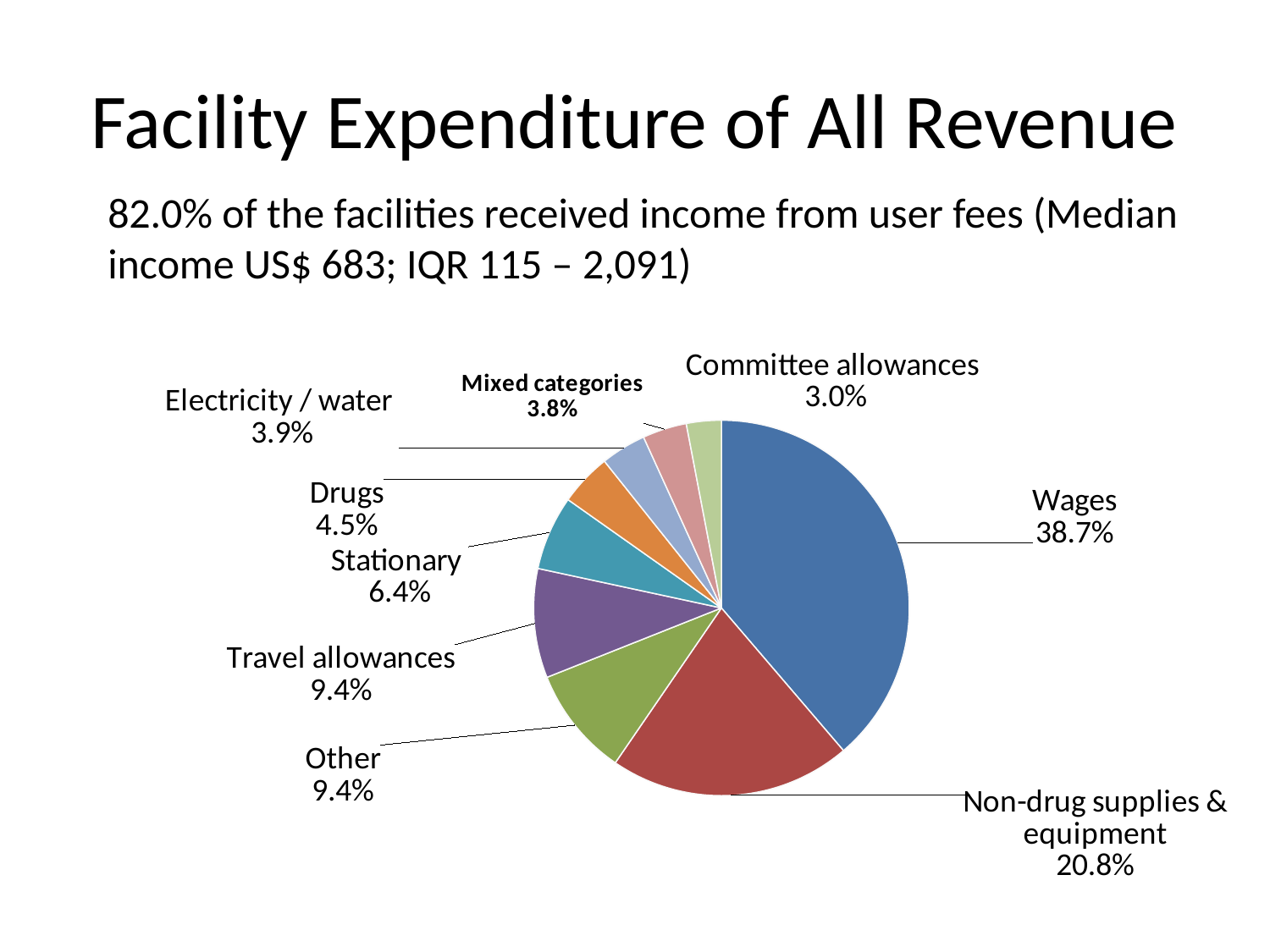
What share of expenditure goes to Committee allowances? 3.0% What share of expenditure goes to Wages? 38.7% How many categories are shown in the pie chart? 9 What is the difference between the shares for Wages and Non-drug supplies & equipment? 17.9% Which has a larger share, Stationary or Drugs? Stationary Which category has the largest share of expenditure? Wages What kind of chart is shown on the slide? pie chart What share of expenditure goes to Non-drug supplies & equipment? 20.8% What share of expenditure goes to Drugs? 4.5% Which category has the smallest share of expenditure? Committee allowances What is the combined share of Travel allowances and Other? 18.8% What is the title of the slide containing the chart? Facility Expenditure of All Revenue